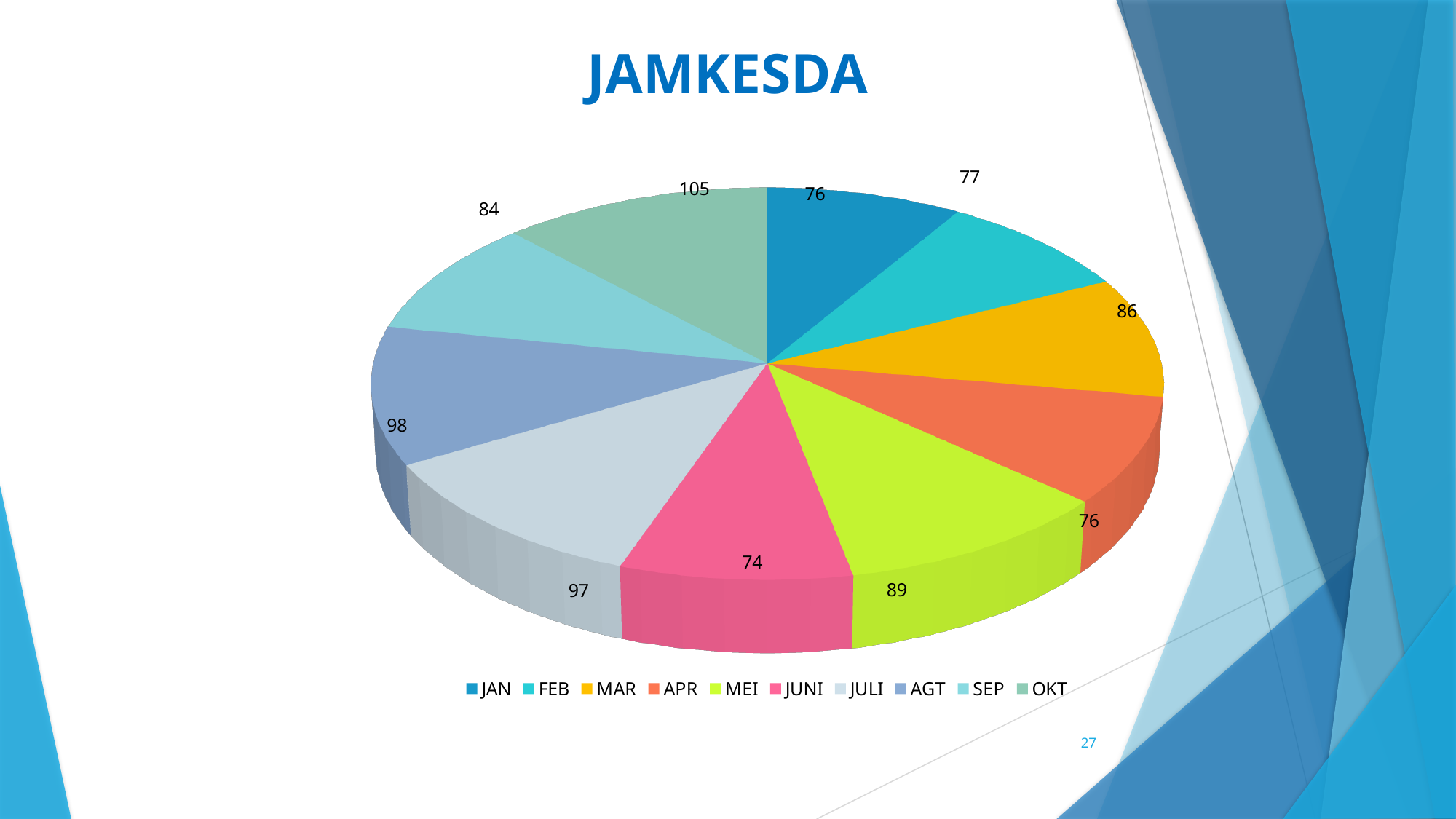
Which month has the highest value? OKT Which month has the lowest value? JUNI What type of chart is shown on the slide? pie chart What is the value for AGT? 98 What is the value for JUNI? 74 What is the value for OKT? 105 How many entries does the legend list? 10 What is the value for MAR? 86 Which is larger, the value for MEI or the value for SEP? MEI What is the title of the chart? JAMKESDA How many slices does the pie chart have? 10 What is the difference between the values for OKT and JUNI? 31